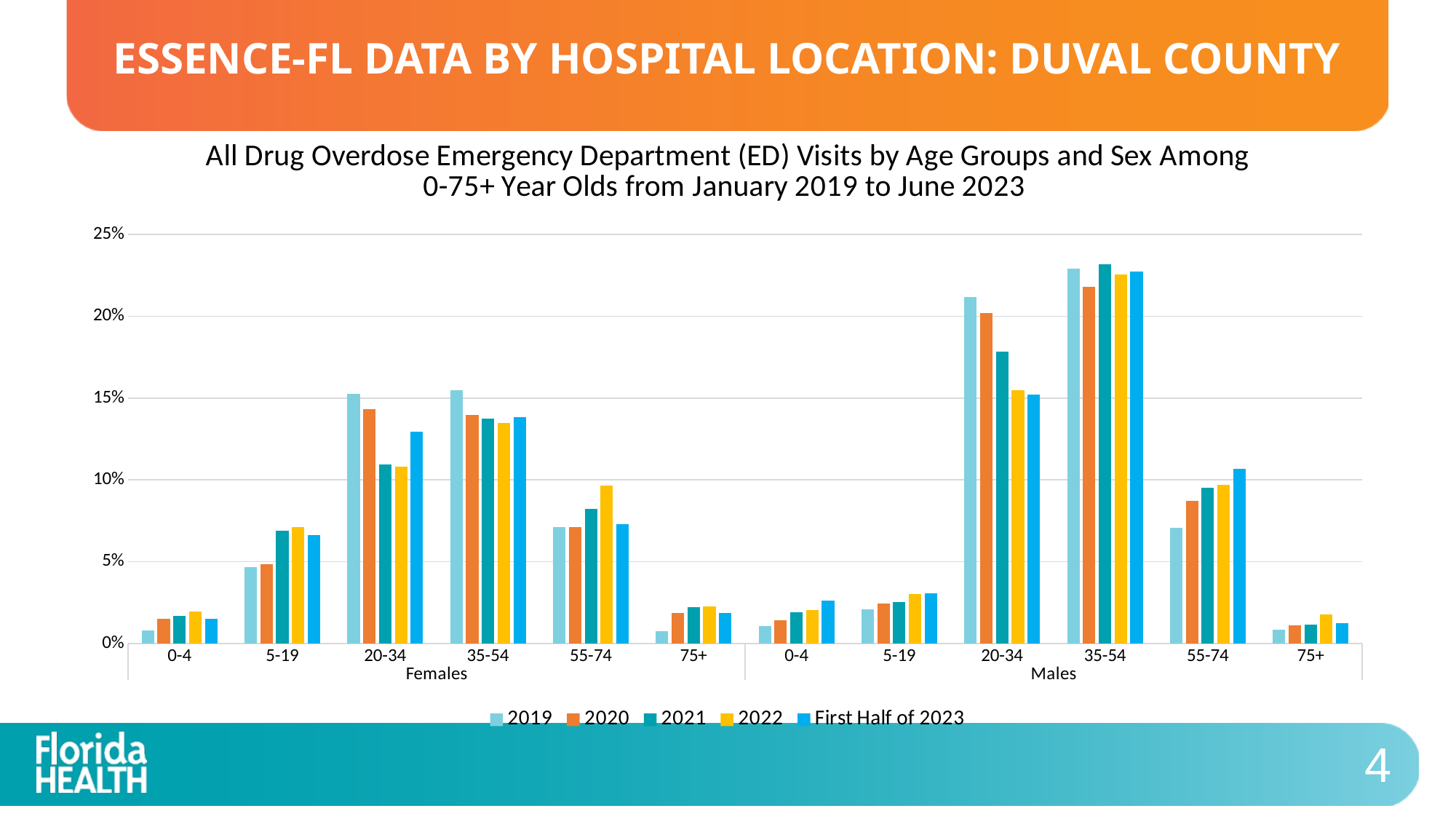
Is the 2019 value for Males aged 20-34 greater or less than 20%? greater For Males aged 55-74, do the values rise or fall from 2019 to First Half of 2023? rise How many series does the legend list? 5 Which is larger for 2019: the value for Males aged 35-54 or Females aged 35-54? Males aged 35-54 Among the Males age groups, which has the highest 2019 value? 35-54 How many age group categories are shown under Females? 6 Is the 2021 value for Males aged 20-34 greater or less than 20%? less What kind of chart is shown on the slide? Bar chart Is the 2021 value for Females aged 20-34 greater or less than 15%? less What is the last entry in the chart's legend? First Half of 2023 For Males aged 20-34, do the values rise or fall from 2019 to First Half of 2023? fall Which is larger for Females aged 20-34: the 2019 value or the First Half of 2023 value? 2019